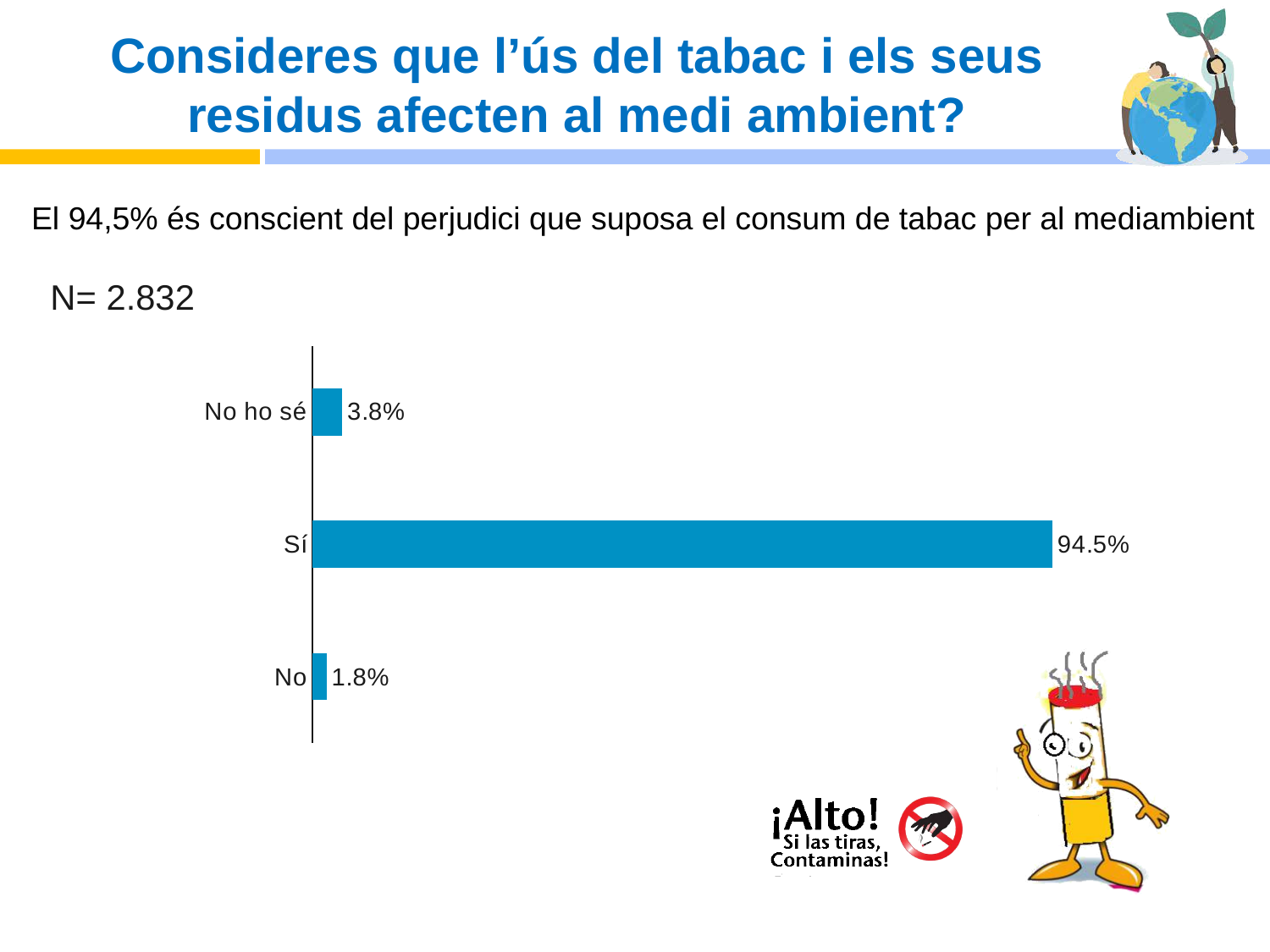
What is the value for "No ho sé"? 3.8% What is the difference between the values for "Sí" and "No ho sé"? 90.7% How many categories are shown in the chart? 3 Which category has the lowest value? No Which category has the highest value? Sí What kind of chart is shown on the slide? Bar chart What is the value for "Sí"? 94.5% What is the sample size (N) stated on the slide? 2.832 What is the difference between the values for "No ho sé" and "No"? 2.0% What colour are the bars in the chart? Blue Which is larger, the value for "No ho sé" or the value for "No"? No ho sé What is the value for "No"? 1.8%